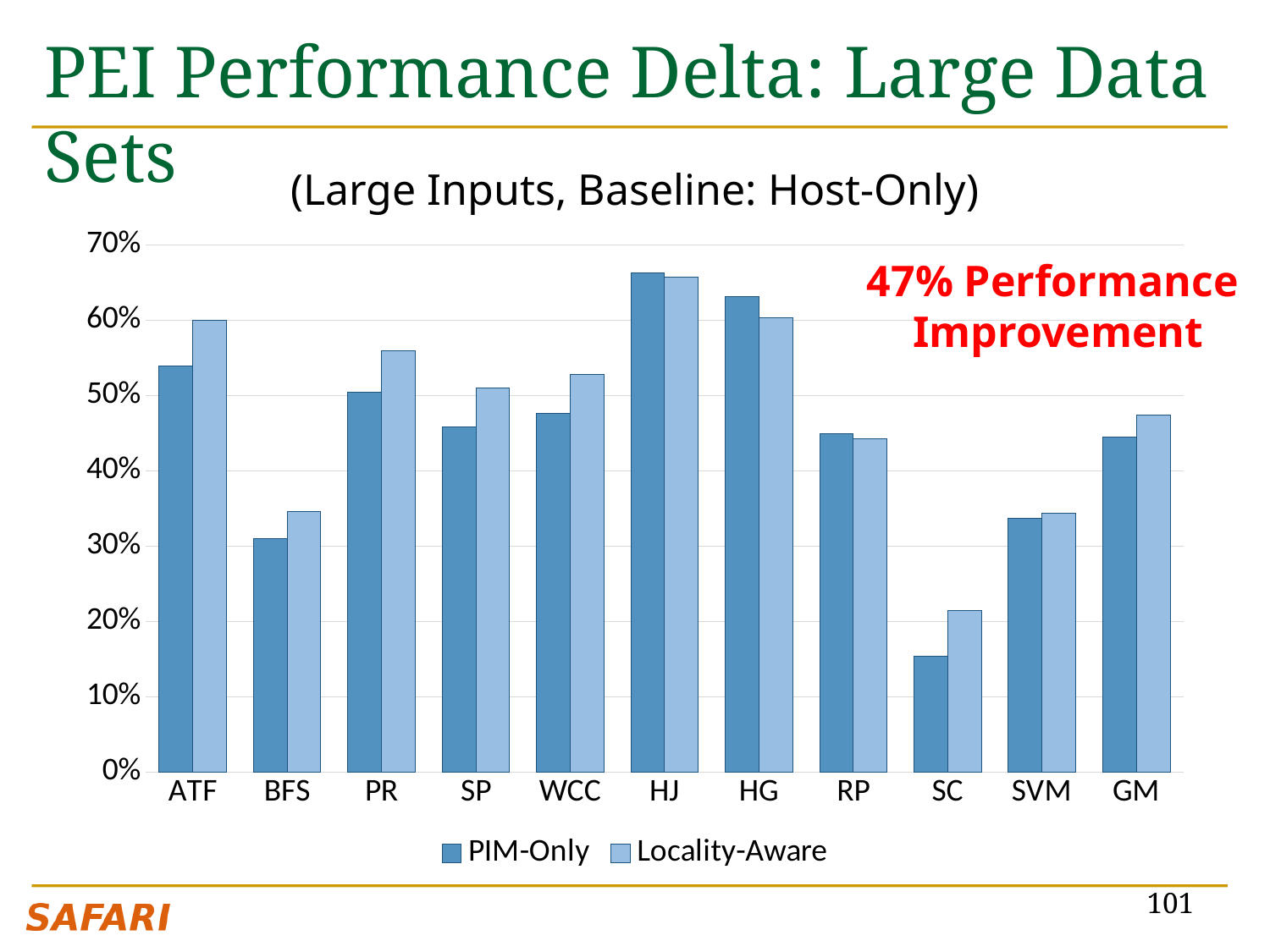
Is the PIM-Only value for HJ greater or less than 60%? greater For ATF, which series has the larger value, PIM-Only or Locality-Aware? Locality-Aware Is the Locality-Aware value for PR greater or less than 50%? greater How many series does the legend list? 2 How many categories are shown on the x axis? 11 Is the PIM-Only value for SC greater or less than 20%? less Which category has the highest PIM-Only value? HJ What performance improvement is called out in the red annotation on the chart? 47% Performance Improvement What kind of chart is shown on the slide? bar chart Which category has the lowest PIM-Only value? SC Which category has the lowest Locality-Aware value? SC For HG, which series has the larger value, PIM-Only or Locality-Aware? PIM-Only